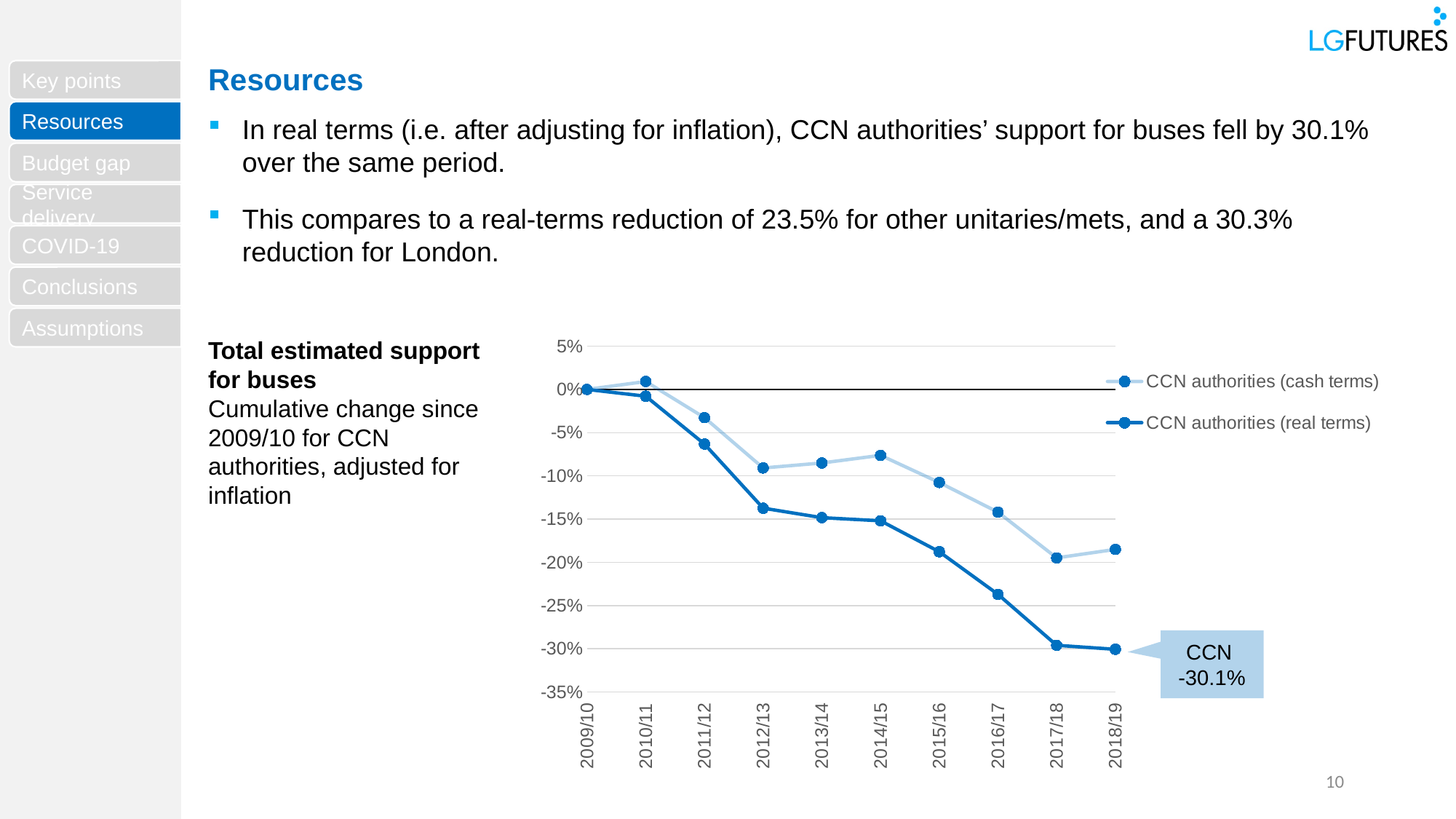
Is the value for CCN authorities (real terms) in 2012/13 greater or less than -10%? less What is the title of the chart? Total estimated support for buses Do the values for CCN authorities (real terms) rise or fall from 2009/10 to 2018/19? fall How many series does the chart legend list? 2 Is the value for CCN authorities (cash terms) in 2014/15 greater or less than -10%? greater What is the value for CCN authorities (real terms) in 2009/10? 0% Is the value for CCN authorities (real terms) in 2016/17 greater or less than -20%? less What kind of chart is shown on the slide? line chart How many years are plotted along the x axis of the chart? 10 What are the two series named in the chart legend? CCN authorities (cash terms) and CCN authorities (real terms) In 2018/19, which series has the higher value: CCN authorities (cash terms) or CCN authorities (real terms)? CCN authorities (cash terms) What is the cumulative change for CCN authorities (real terms) in 2018/19? -30.1%